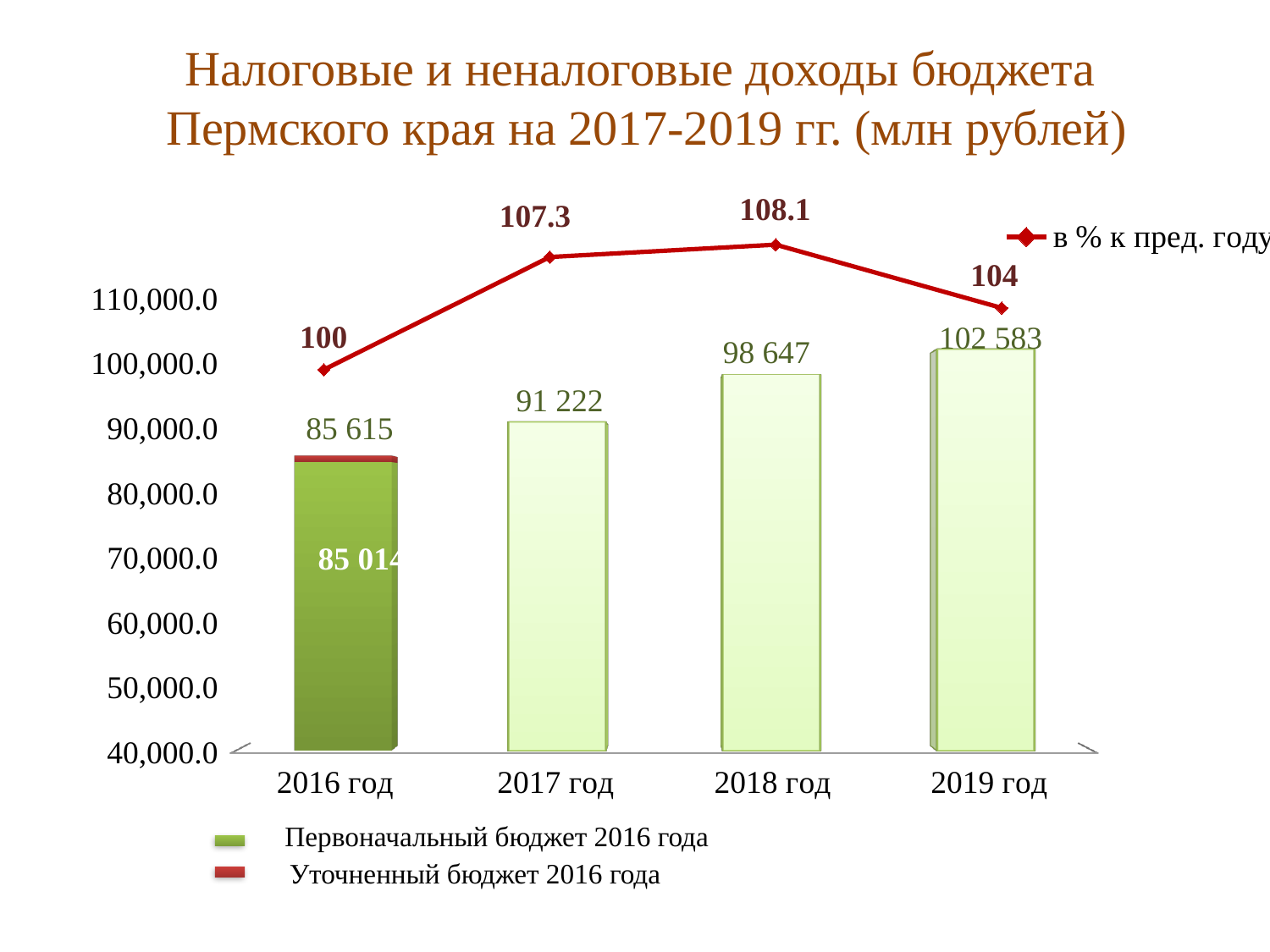
What is the value printed inside the dark green bar for 2016 год (Первоначальный бюджет 2016 года)? 85 014 What is the value of the bar for 2017 год? 91 222 Which is larger, the bar value for 2017 год or for 2018 год? 2018 год In which year does the line 'в % к пред. году' reach its highest value? 2018 год What value does the line 'в % к пред. году' show for 2018 год? 108.1 Which year has the highest bar value? 2019 год How many years are shown on the x axis? 4 What is the value of the bar for 2019 год? 102 583 What is the value of the bar for 2018 год? 98 647 What is the difference between the bar values for 2019 год and 2018 год? 3 936 What value does the line 'в % к пред. году' show for 2019 год? 104 Do the bar values rise or fall from 2016 год to 2019 год? rise